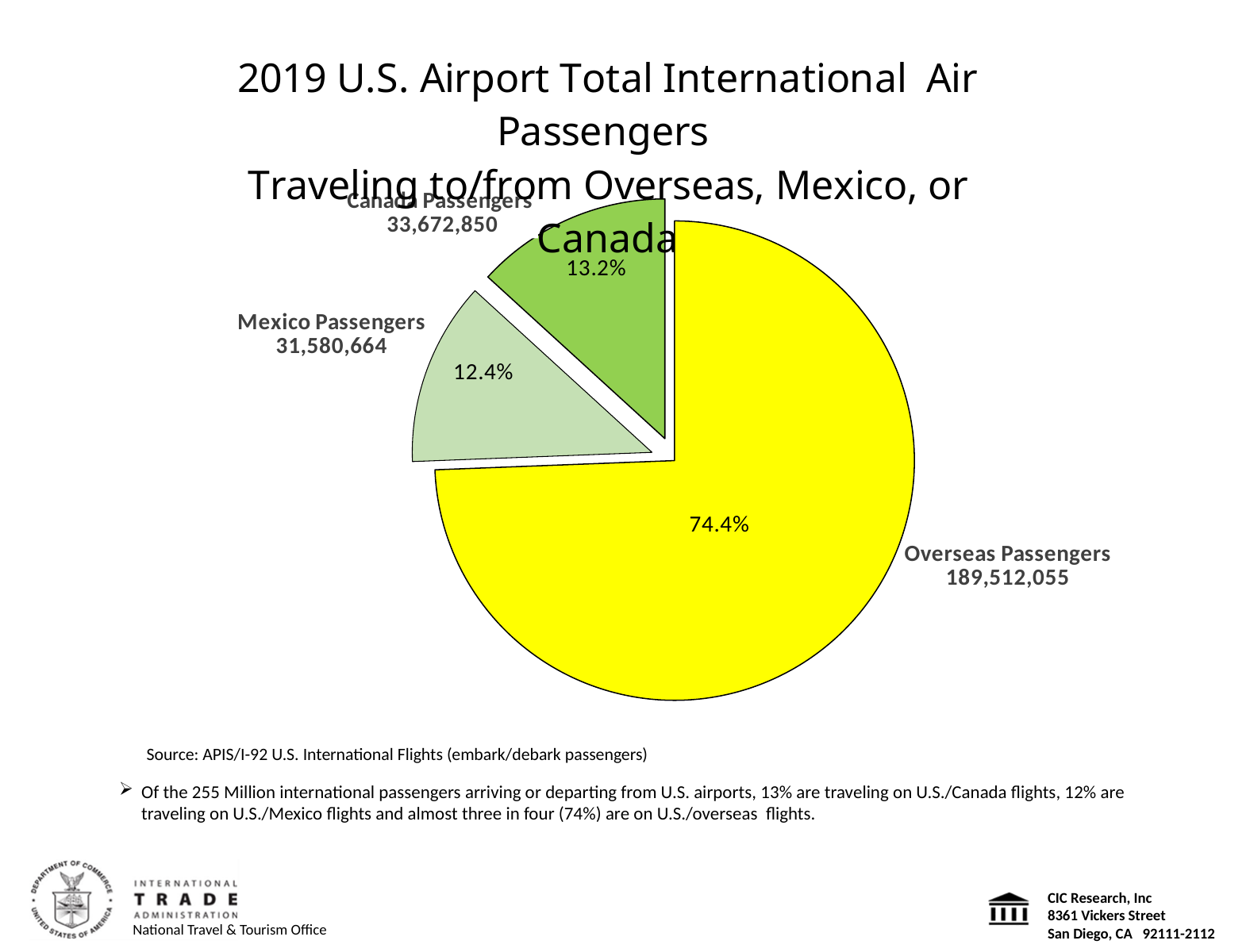
Which passenger group has the smallest slice of the pie? Mexico Passengers How many slices does the pie chart have? 3 What is the difference between the number of Canada Passengers and Mexico Passengers? 2,092,186 Which passenger group has the largest slice of the pie? Overseas Passengers Which is larger, the number of Canada Passengers or Mexico Passengers? Canada Passengers What kind of chart is shown on the slide? Pie chart What share of the pie do Canada Passengers represent? 13.2% How many Mexico Passengers are shown in the pie chart? 31,580,664 What colour is the Overseas Passengers slice of the pie? Yellow What share of the pie do Overseas Passengers represent? 74.4% How many Canada Passengers are shown in the pie chart? 33,672,850 How many Overseas Passengers are shown in the pie chart? 189,512,055